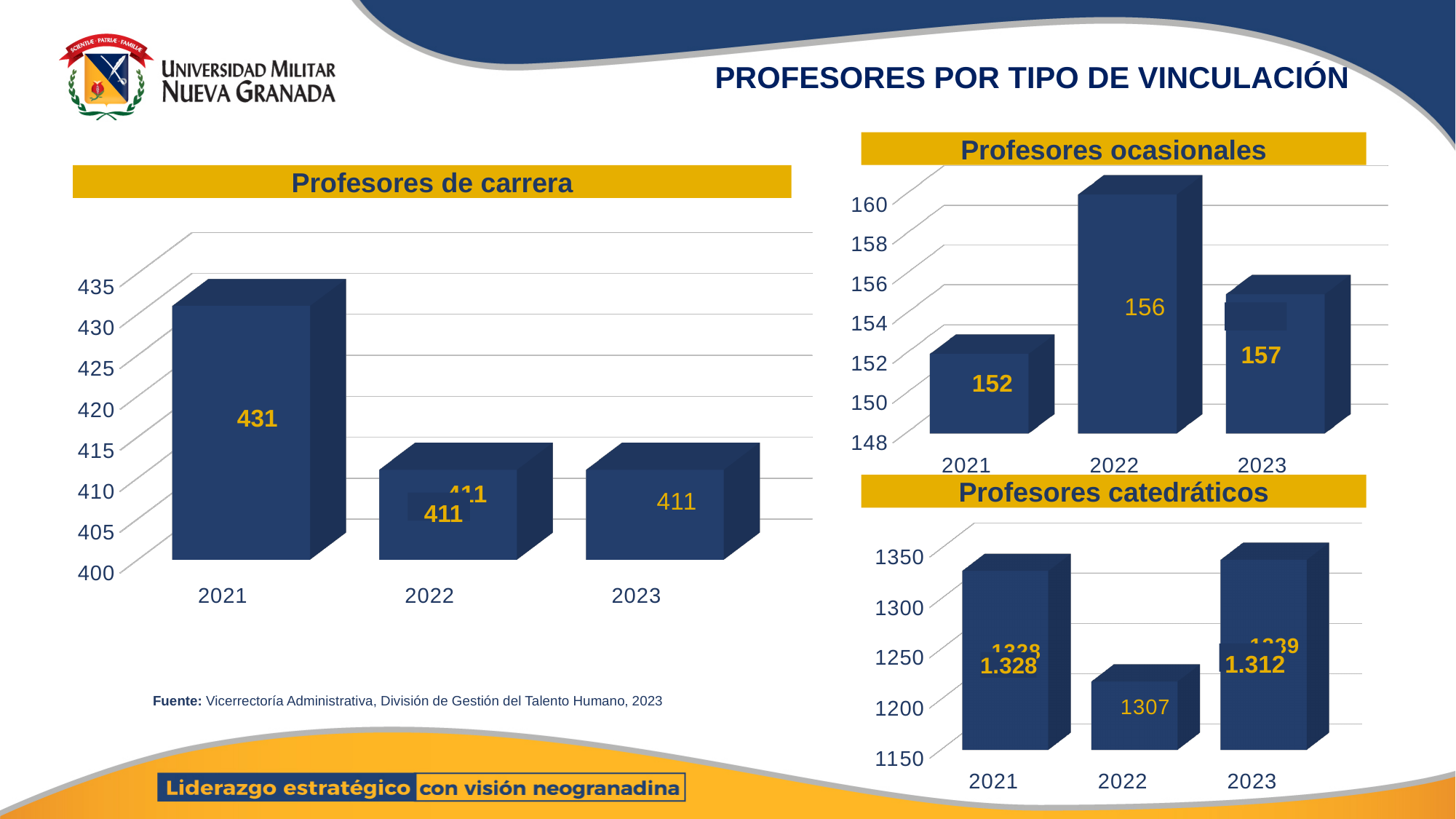
In the 'Profesores de carrera' chart, what is the value for 2021? 431 In the 'Profesores de carrera' chart, what is the difference between the 2021 and 2023 values? 20 What kind of chart is the 'Profesores de carrera' chart? bar chart In the 'Profesores de carrera' chart, how many years are shown on the x axis? 3 In the 'Profesores ocasionales' chart, which year has the lowest value? 2021 In the 'Profesores catedráticos' chart, which year has the lowest value? 2022 In the 'Profesores catedráticos' chart, what is the value for 2022? 1307 In the 'Profesores ocasionales' chart, is the value for 2021 greater or less than 154? less In the 'Profesores de carrera' chart, which year has the highest value? 2021 How many charts are shown on the slide? 3 In the 'Profesores ocasionales' chart, what is the value for 2021? 152 In the 'Profesores de carrera' chart, what is the value for 2023? 411